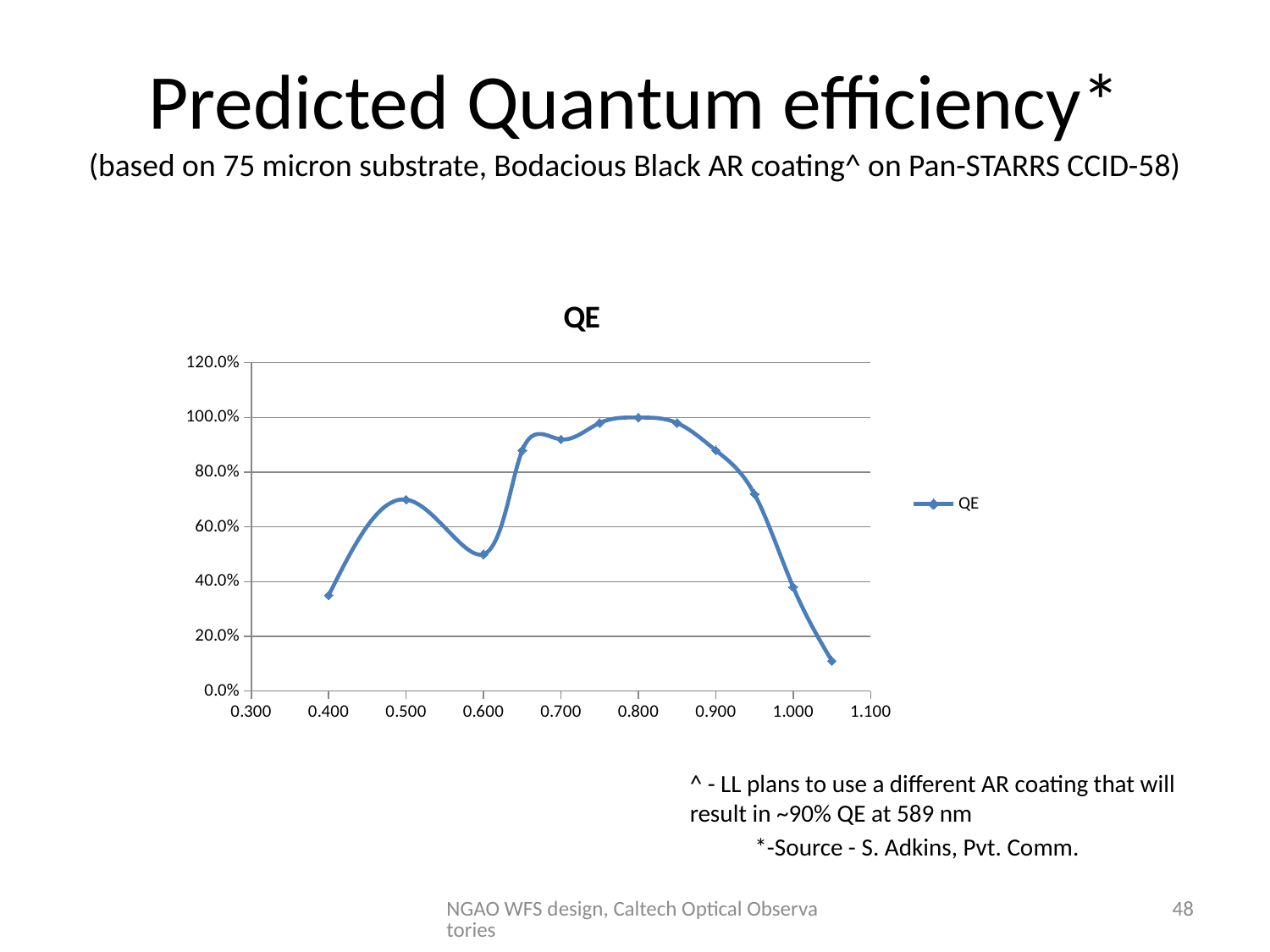
Is the QE value at 0.400 greater or less than 40.0%? less How many series does the legend list? 1 What is the title of the chart? QE Is the QE value at 0.500 greater or less than 60.0%? greater At which x value does the QE line reach its highest point? 0.800 What kind of chart is shown on the slide? line chart Is the QE value at 0.900 greater or less than 80.0%? greater Which has the higher QE value, 0.500 or 0.600? 0.500 Does the QE value rise or fall along the x axis from 0.800 to 1.050? fall How many data points are plotted on the QE line? 12